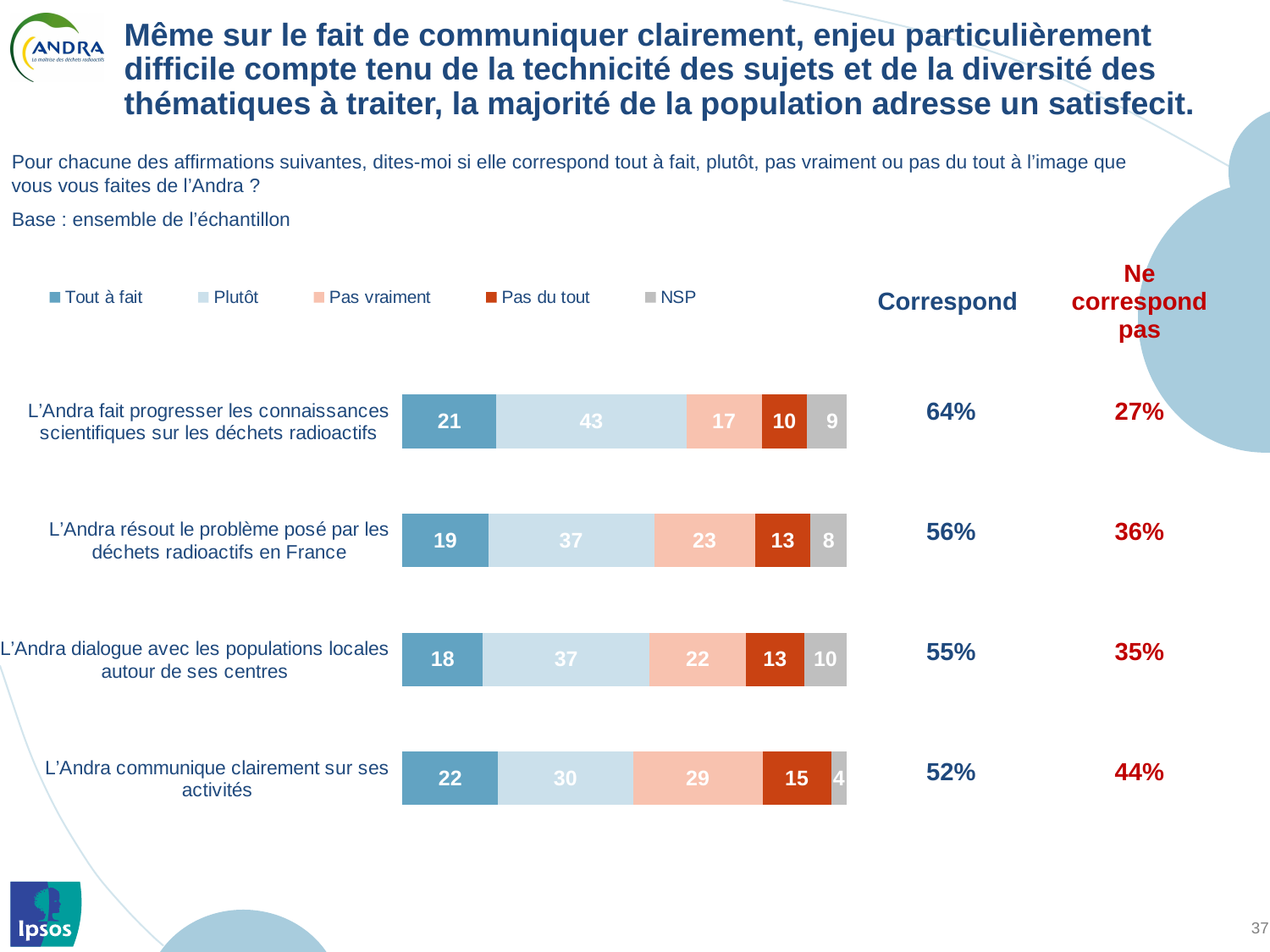
What kind of chart is shown on the slide? Stacked bar chart What is the "Tout à fait" value for "L'Andra communique clairement sur ses activités"? 22 What is the difference between the "Plutôt" values for "L'Andra fait progresser les connaissances scientifiques sur les déchets radioactifs" and "L'Andra communique clairement sur ses activités"? 13 Which statement has the highest "Pas du tout" value? L'Andra communique clairement sur ses activités What is the "Correspond" percentage shown for "L'Andra résout le problème posé par les déchets radioactifs en France"? 56% What is the "Pas vraiment" value for "L'Andra résout le problème posé par les déchets radioactifs en France"? 23 What is the NSP value for "L'Andra dialogue avec les populations locales autour de ses centres"? 10 Which is larger: the "Pas vraiment" value for "L'Andra communique clairement sur ses activités" or for "L'Andra fait progresser les connaissances scientifiques sur les déchets radioactifs"? L'Andra communique clairement sur ses activités How many series does the legend list? 5 How many statements (bars) are shown in the chart? 4 What is the "Plutôt" value for "L'Andra fait progresser les connaissances scientifiques sur les déchets radioactifs"? 43 Which statement has the lowest NSP value? L'Andra communique clairement sur ses activités